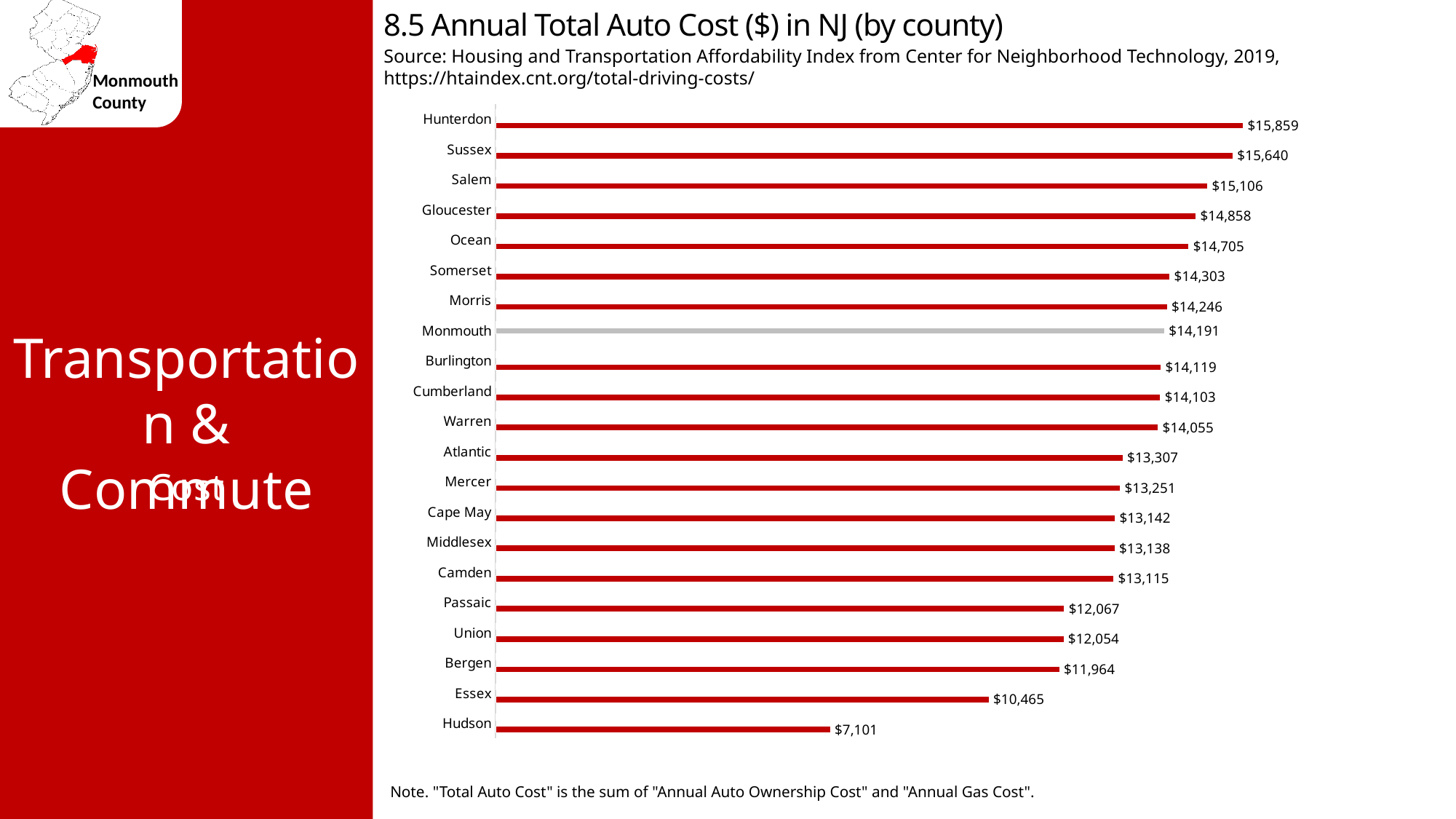
What is the annual total auto cost for Monmouth County? $14,191 What is the difference in annual total auto cost between Monmouth and Hudson counties? $7,090 Which county has the lowest annual total auto cost? Hudson Which county's bar is shown in a different colour (grey) from the others? Monmouth How many counties are shown in the chart? 21 Which county has the highest annual total auto cost? Hunterdon What is the annual total auto cost for Hudson County? $7,101 Which county has a higher annual total auto cost, Ocean or Somerset? Ocean What kind of chart is used to show annual total auto cost by county? Bar chart What is the annual total auto cost for Ocean County? $14,705 What is the difference in annual total auto cost between Hunterdon and Hudson counties? $8,758 Which county has a higher annual total auto cost, Essex or Bergen? Bergen